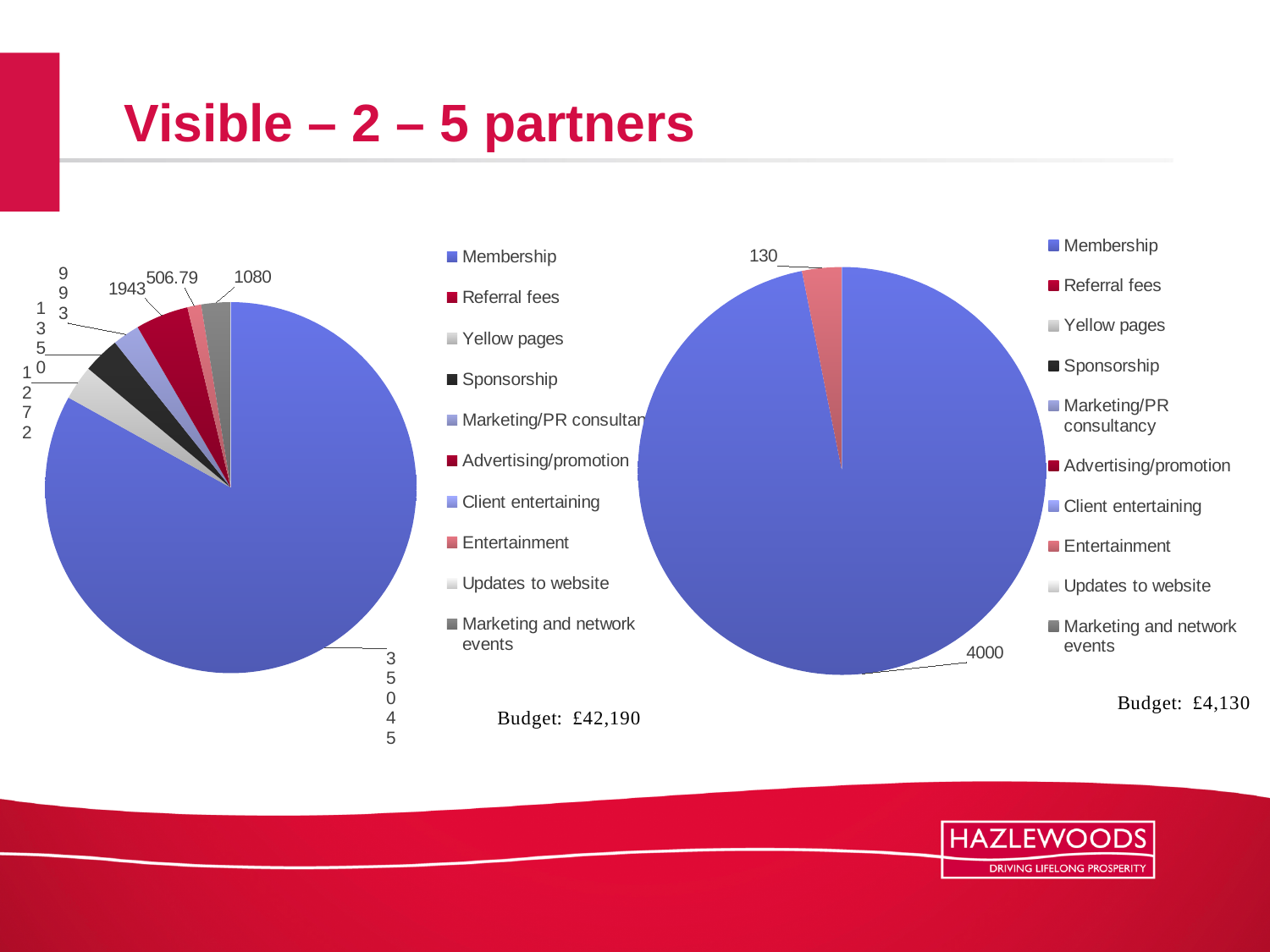
In the left pie chart, what is the value for Entertainment? 506.79 In the right pie chart, what is the difference between the Membership value and the Entertainment value? 3870 In the left pie chart, which category has the largest slice? Membership What type of charts are shown on the slide? Pie charts In the right pie chart, what is the value for Membership? 4000 In the left pie chart, which is larger: Advertising/promotion or Entertainment? Advertising/promotion In the left pie chart, what is the value for Advertising/promotion? 1943 In the right pie chart, what is the value for Entertainment? 130 In the left pie chart, what is the value for Marketing and network events? 1080 What budget is stated below the left pie chart? £42,190 In the right pie chart, which category has the smallest slice? Entertainment How many entries does the legend of the right pie chart list? 10